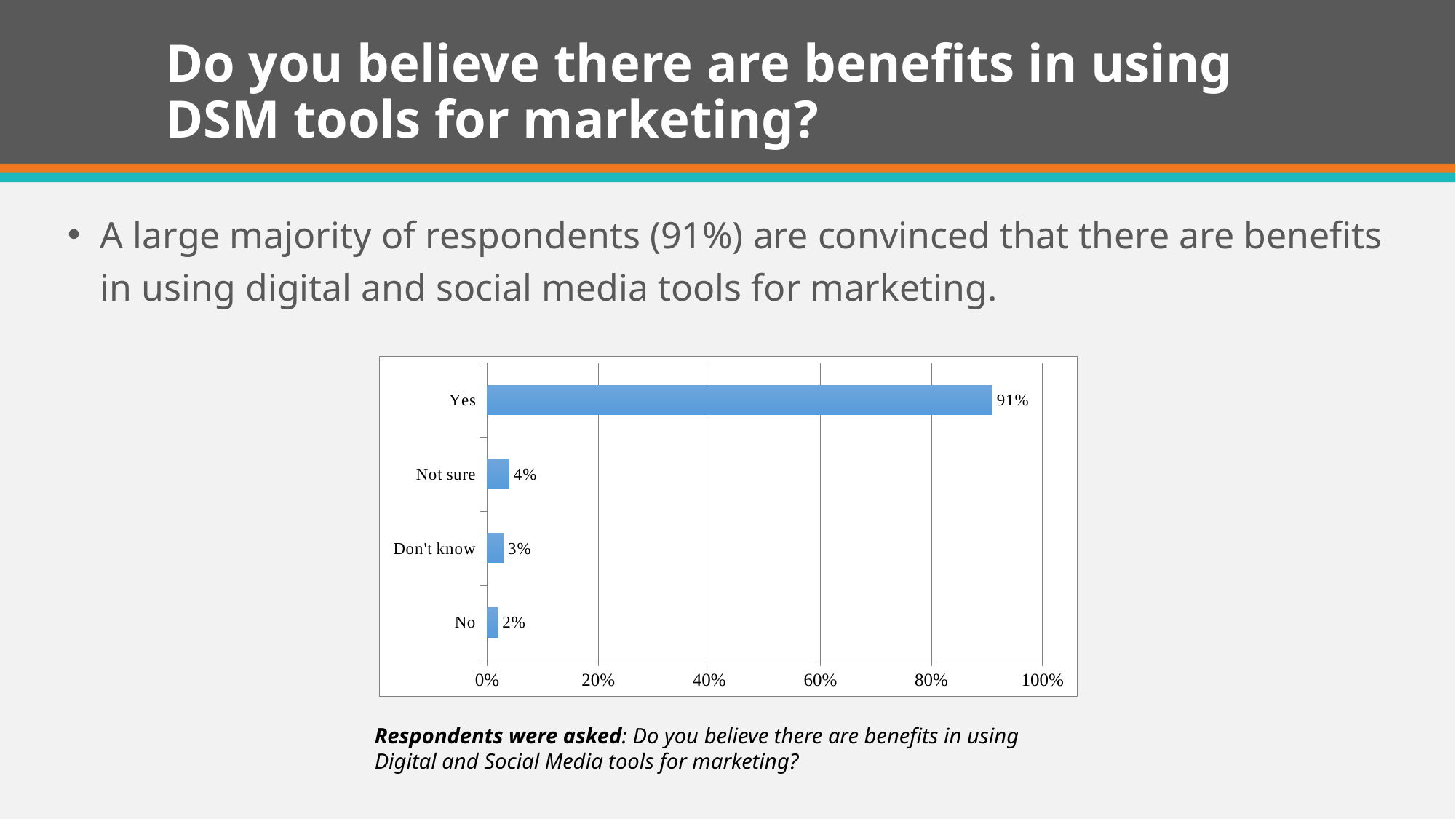
How many response categories are shown in the chart? 4 What is the difference between the "Yes" and "No" percentages? 89% What percentage of respondents answered "Not sure"? 4% Is the value for "Yes" greater or less than 80%? greater What type of chart is shown on the slide? Bar chart What is the difference between the "Not sure" and "Don't know" percentages? 1% What percentage of respondents answered "Yes"? 91% What percentage of respondents answered "Don't know"? 3% Which is larger, the value for "Not sure" or the value for "No"? Not sure What percentage of respondents answered "No"? 2% Which response category has the lowest value? No Which response category has the highest value? Yes